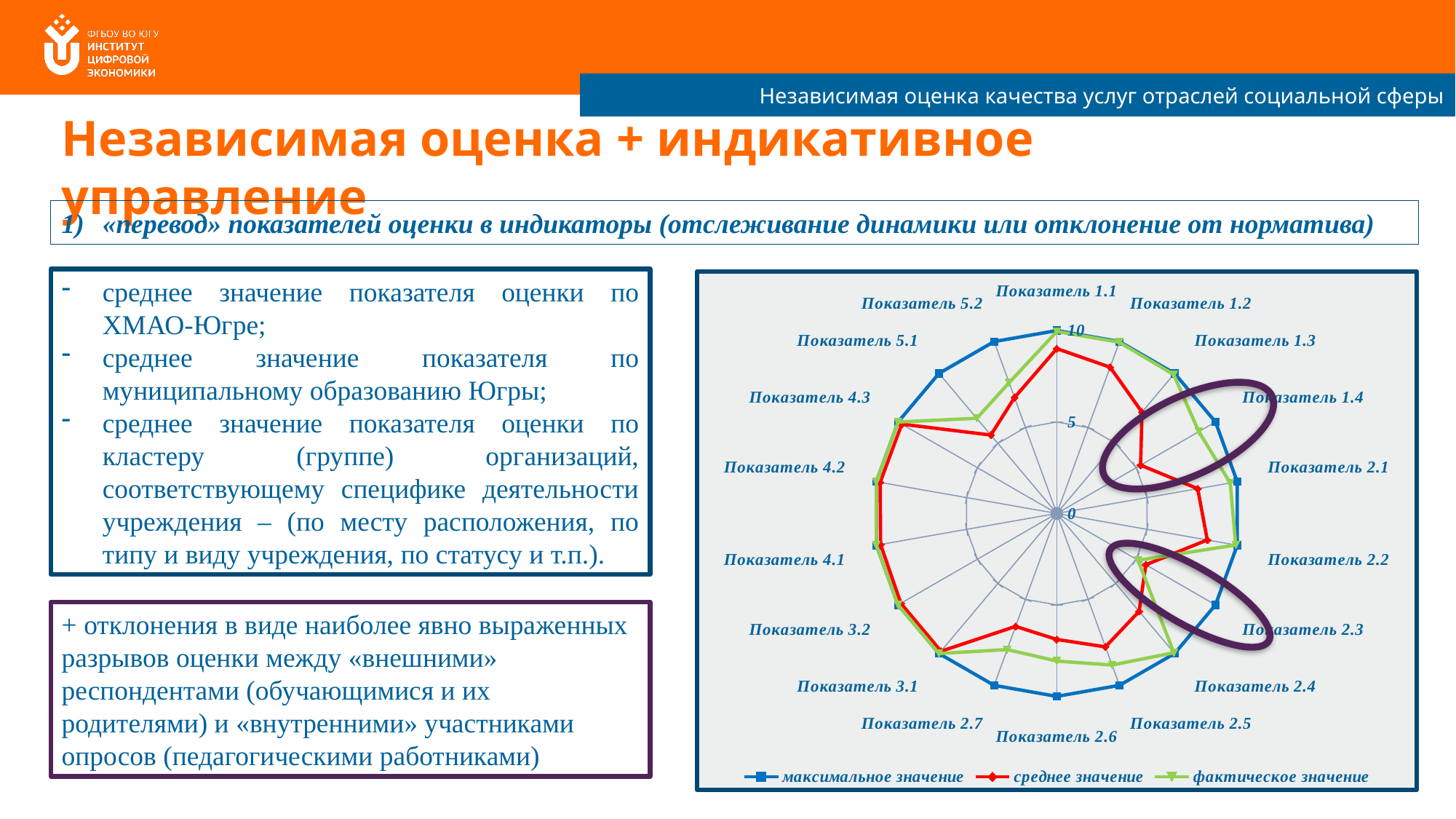
Is the фактическое значение for Показатель 4.3 greater or less than 5? greater What kind of chart is shown on the right side of the slide? radar chart For Показатель 1.1, which is larger: the максимальное значение or the среднее значение? максимальное значение What is the highest value shown on the radial axis of the radar chart? 10 What are the three series named in the legend of the radar chart? максимальное значение, среднее значение, фактическое значение Is the максимальное значение for Показатель 2.4 greater or less than 5? greater How many categories (показатели) are plotted around the radar chart? 18 Is the фактическое значение for Показатель 2.6 greater or less than 5? greater How many series does the legend of the radar chart list? 3 For Показатель 2.3, which is larger: the максимальное значение or the фактическое значение? максимальное значение